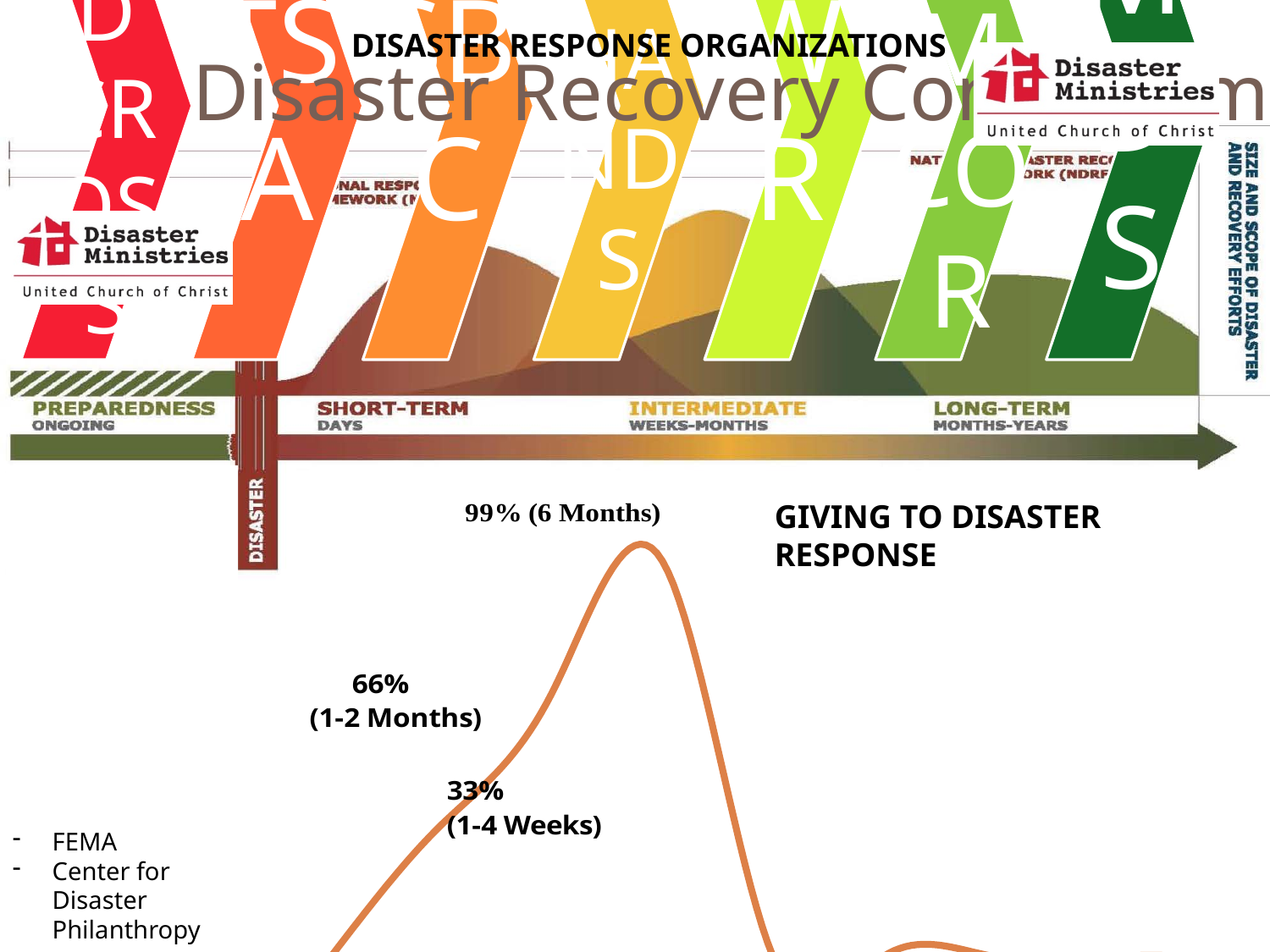
On the 'GIVING TO DISASTER RESPONSE' chart, which labelled time period has the lowest value? 1-4 Weeks On the 'GIVING TO DISASTER RESPONSE' chart, what value is labelled at 6 Months? 99% What kind of chart is the 'GIVING TO DISASTER RESPONSE' chart? Line chart On the 'GIVING TO DISASTER RESPONSE' chart, do the labelled values rise or fall from 1-4 Weeks to 6 Months? Rise On the 'GIVING TO DISASTER RESPONSE' chart, which is larger: the value for 1-2 Months or the value for 1-4 Weeks? 1-2 Months On the 'GIVING TO DISASTER RESPONSE' chart, what is the difference between the 6 Months value and the 1-4 Weeks value? 66% What colour is the line on the 'GIVING TO DISASTER RESPONSE' chart? Orange On the 'GIVING TO DISASTER RESPONSE' chart, what is the difference between the 6 Months value and the 1-2 Months value? 33% On the 'GIVING TO DISASTER RESPONSE' chart, which labelled time period has the highest value? 6 Months On the 'GIVING TO DISASTER RESPONSE' chart, what value is labelled for 1-4 Weeks? 33% On the 'GIVING TO DISASTER RESPONSE' chart, how many labelled data points are shown? 3 On the 'GIVING TO DISASTER RESPONSE' chart, what value is labelled for 1-2 Months? 66%